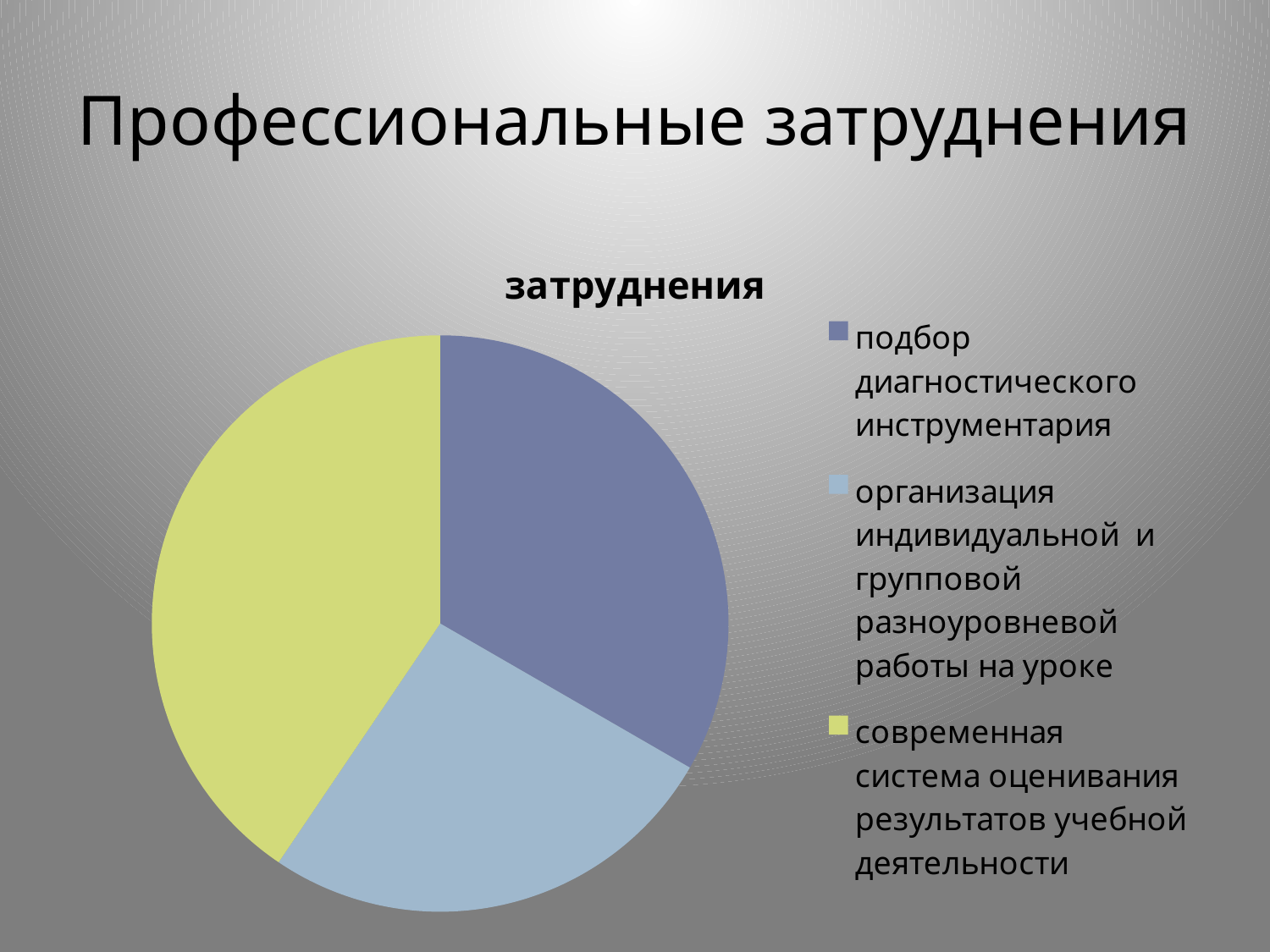
Which slice is larger: "современная система оценивания результатов учебной деятельности" or "организация индивидуальной и групповой разноуровневой работы на уроке"? современная система оценивания результатов учебной деятельности Which slice is larger: "подбор диагностического инструментария" or "организация индивидуальной и групповой разноуровневой работы на уроке"? подбор диагностического инструментария How many slices does the pie chart have? 3 What kind of chart is shown on the slide? pie chart What colour is the slice for "подбор диагностического инструментария"? dark blue Which category has the largest slice of the pie? современная система оценивания результатов учебной деятельности How many entries does the legend list? 3 What is the title of the chart? затруднения Is the slice for "современная система оценивания результатов учебной деятельности" greater or less than half of the pie? less Which category has the smallest slice of the pie? организация индивидуальной и групповой разноуровневой работы на уроке